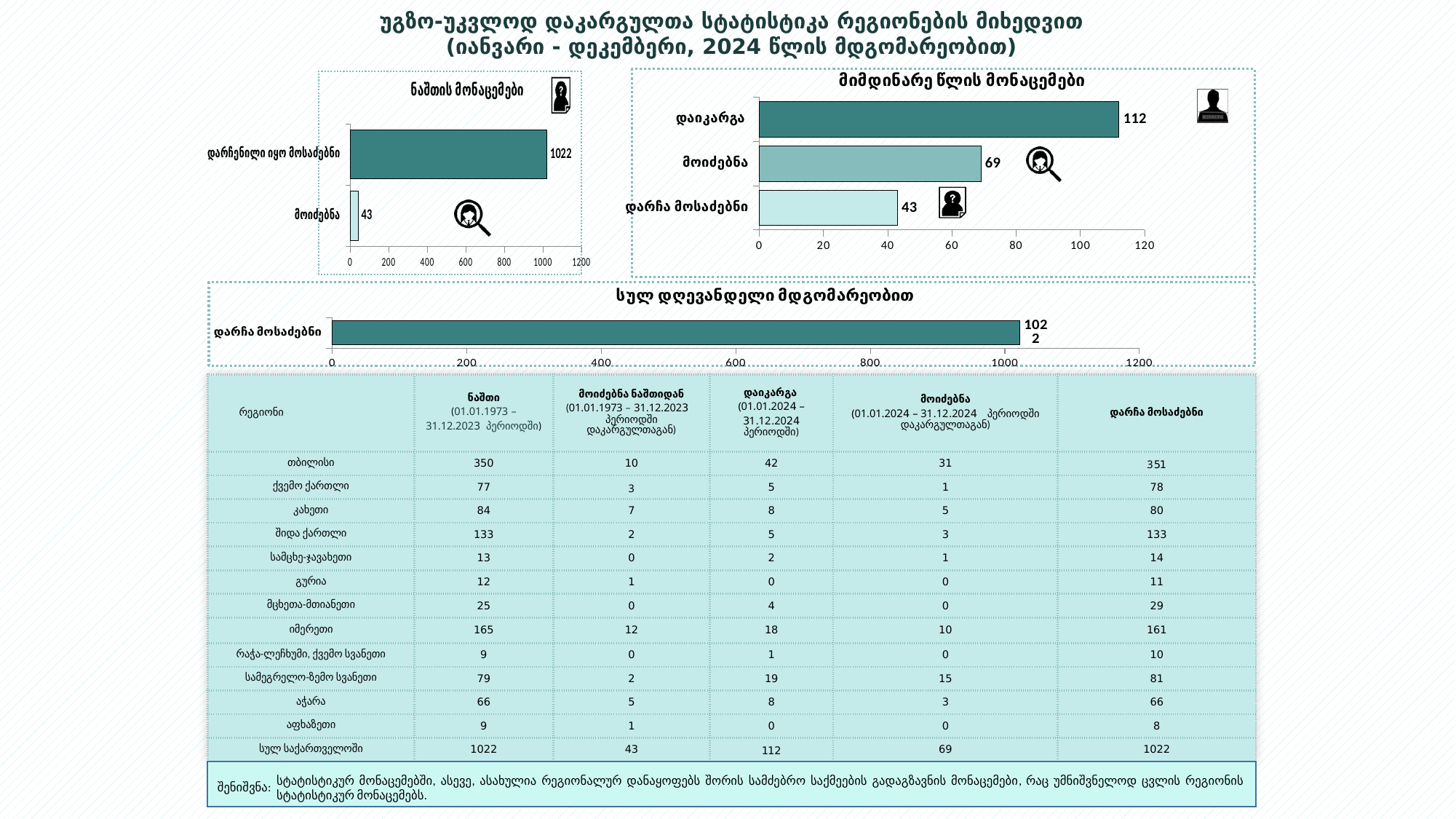
In the top-right chart titled "მიმდინარე წლის მონაცემები", what is the difference between "დაიკარგა" and "მოიძებნა"? 43 In the top-right chart titled "მიმდინარე წლის მონაცემები", which category has the lowest value? დარჩა მოსაძებნი In the top-left chart titled "ნაშთის მონაცემები", what is the difference between "დარჩენილი იყო მოსაძებნი" and "მოიძებნა"? 979 In the top-right chart titled "მიმდინარე წლის მონაცემები", which category has the highest value? დაიკარგა In the top-right chart titled "მიმდინარე წლის მონაცემები", what is the value for "მოიძებნა"? 69 In the top-left chart titled "ნაშთის მონაცემები", what is the value for "დარჩენილი იყო მოსაძებნი"? 1022 In the top-right chart titled "მიმდინარე წლის მონაცემები", is the value for "მოიძებნა" greater or less than 60? greater How many categories are shown in the top-right chart titled "მიმდინარე წლის მონაცემები"? 3 In the top-left chart titled "ნაშთის მონაცემები", what is the value for "მოიძებნა"? 43 In the top-right chart titled "მიმდინარე წლის მონაცემები", what is the value for "დაიკარგა"? 112 What type of chart is the bottom chart titled "სულ დღევანდელი მდგომარეობით"? Bar chart In the bottom chart titled "სულ დღევანდელი მდგომარეობით", what is the value for "დარჩა მოსაძებნი"? 1022